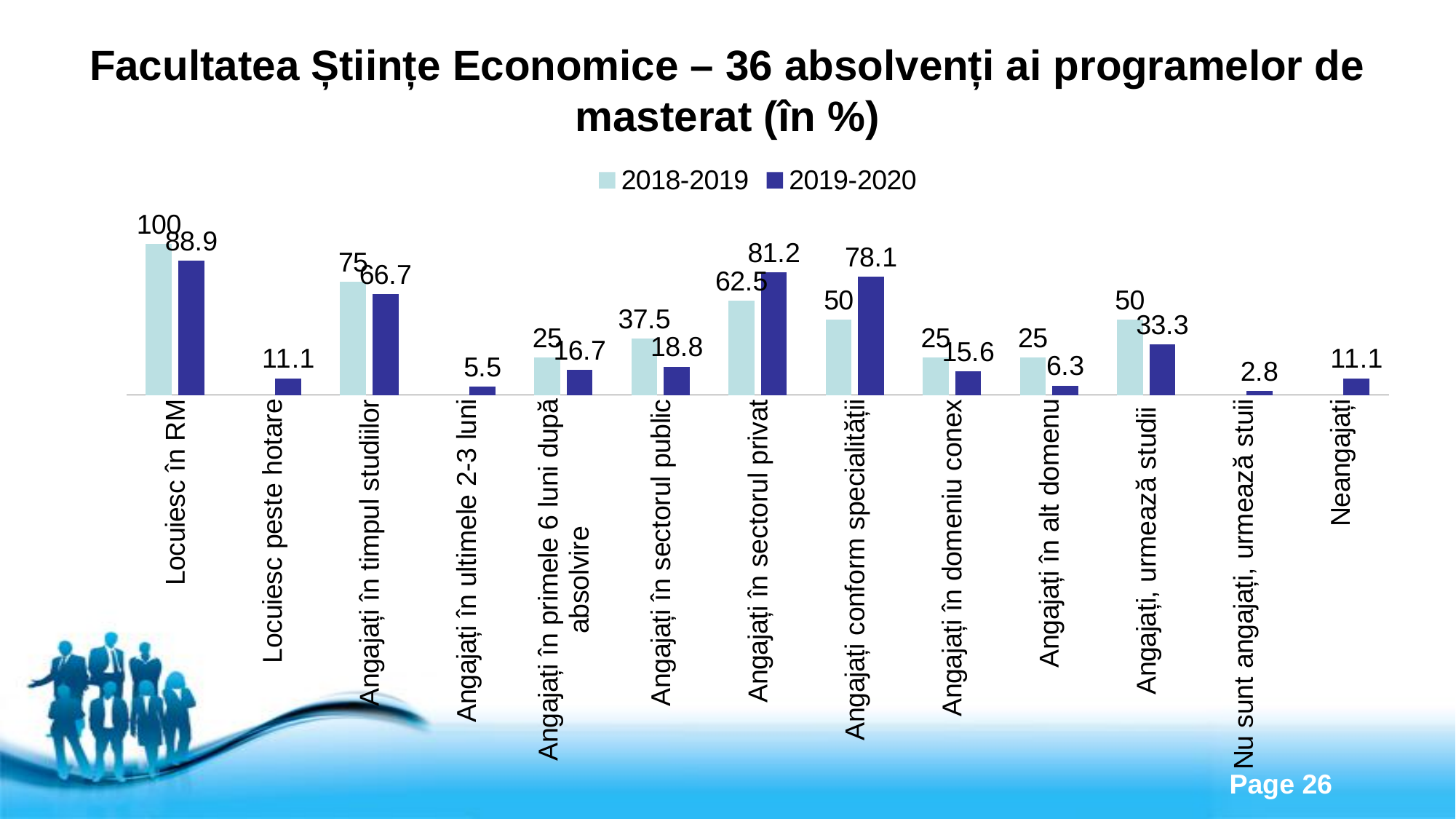
What is the 2019-2020 value for "Angajați în sectorul privat"? 81.2 For "Angajați conform specialității", which series has the larger value, 2018-2019 or 2019-2020? 2019-2020 What is the 2018-2019 value for "Angajați în sectorul public"? 37.5 How many series does the legend list? 2 What is the 2019-2020 value for "Neangajați"? 11.1 What is the difference between the 2018-2019 and 2019-2020 values for "Angajați în timpul studiilor"? 8.3 For "Angajați în alt domenu", which series has the larger value, 2018-2019 or 2019-2020? 2018-2019 How many categories are shown on the x axis? 13 What is the 2019-2020 value for "Angajați conform specialității"? 78.1 Which category has the lowest 2019-2020 value? Nu sunt angajați, urmează stuii What kind of chart is shown on the slide? Bar chart Which category has the highest 2018-2019 value? Locuiesc în RM